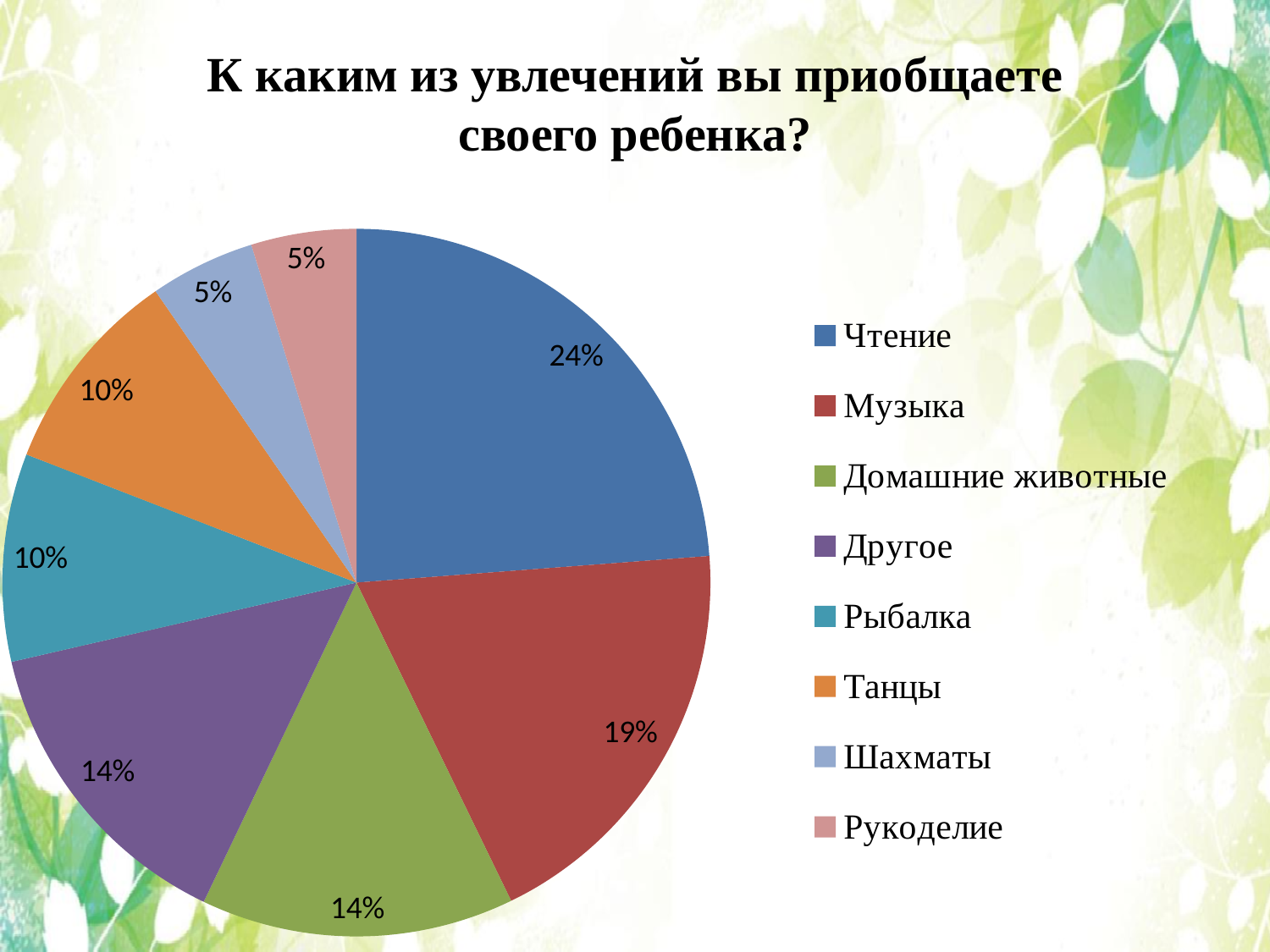
What is the difference in percentage points between Чтение and Музыка? 5% What is the difference in percentage points between Домашние животные and Рукоделие? 9% What share of the pie does Шахматы have? 5% What share of the pie does Чтение have? 24% How many categories does the legend list? 8 Which category has the largest slice of the pie? Чтение What kind of chart is shown on the slide? pie chart What share of the pie does Рыбалка have? 10% What is the title of the chart? К каким из увлечений вы приобщаете своего ребенка? Which is larger, the share for Музыка or the share for Танцы? Музыка Which category is shown in orange in the legend? Танцы